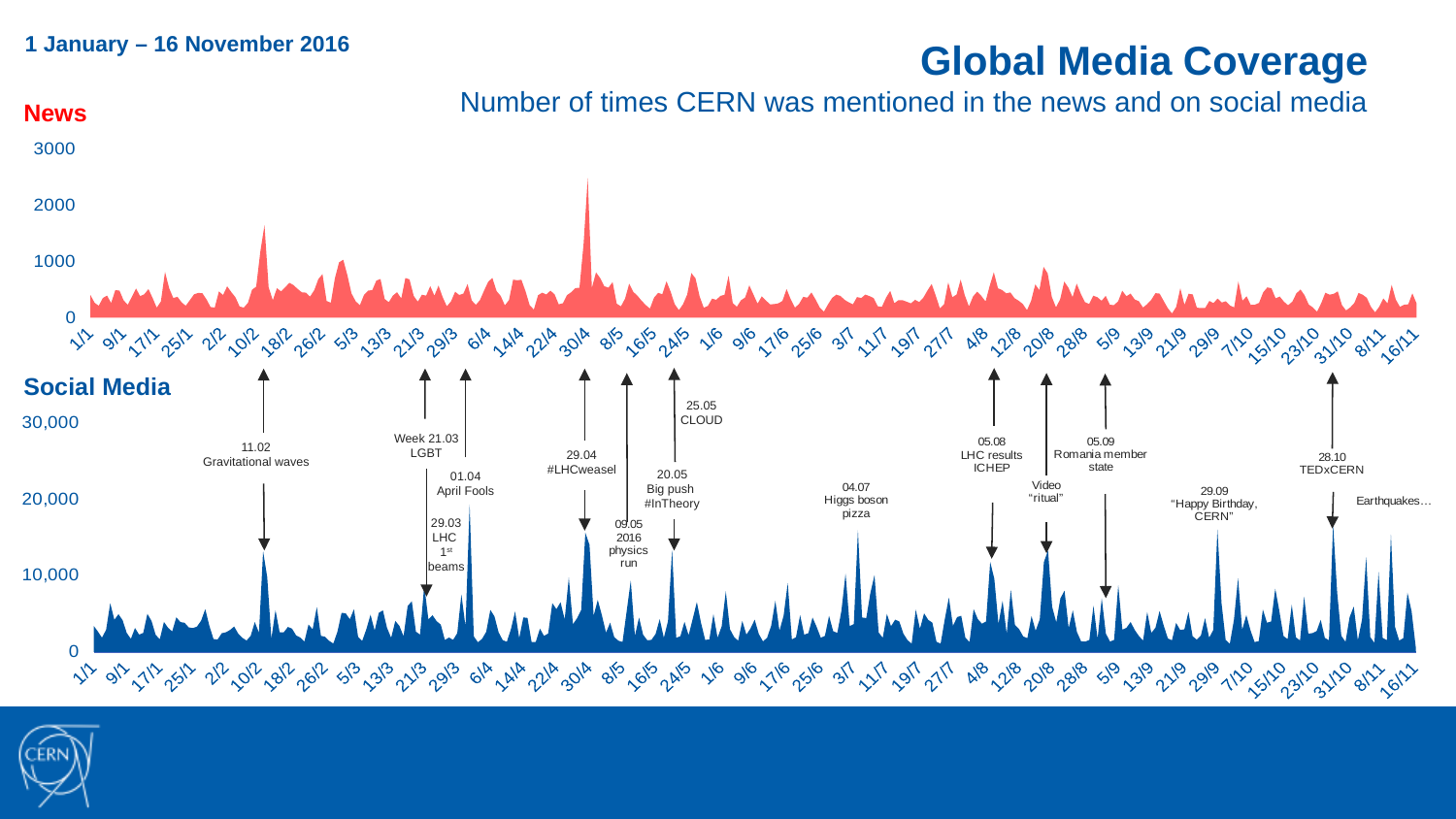
What is the highest value shown on the y axis of the Social Media chart? 30,000 In the Social Media chart, is the peak near 29/9 greater or less than 20,000? less What is the highest value shown on the y axis of the News chart? 3000 In the News chart, around which date does the highest peak occur? 30/4 What kind of chart is the News chart? area chart What colour is the Social Media chart's area? blue How many charts are shown on the slide? 2 In the News chart, is the peak near 10/2 greater or less than 1000? greater In the Social Media chart, is the peak near 10/2 greater or less than 20,000? less What is the title of the slide's charts? Global Media Coverage